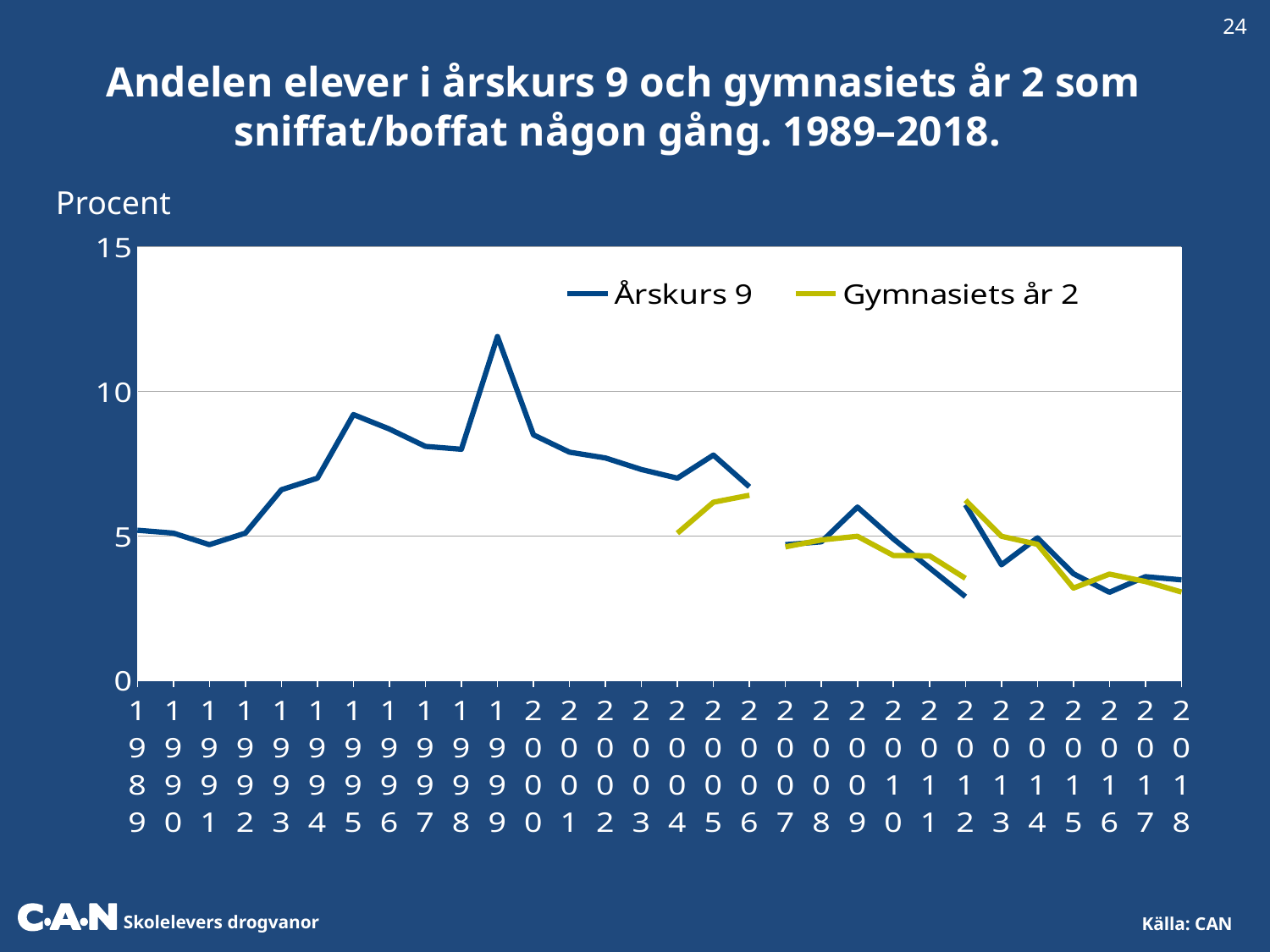
How many years are shown along the x axis? 30 Is the value for Årskurs 9 in 1999 greater or less than 10? greater In 2012, which series has the larger value, Årskurs 9 or Gymnasiets år 2? Gymnasiets år 2 What label is shown on the vertical axis of the chart? Procent Is the value for Gymnasiets år 2 in 2006 greater or less than 5? greater How many series does the legend list? 2 Does the Årskurs 9 series rise or fall between 1999 and 2004? fall In which year does the Årskurs 9 series reach its highest value? 1999 Is the value for Årskurs 9 in 1995 greater or less than 10? less What kind of chart is shown on the slide? line chart Which is larger for Årskurs 9: the value in 1989 or the value in 1999? 1999